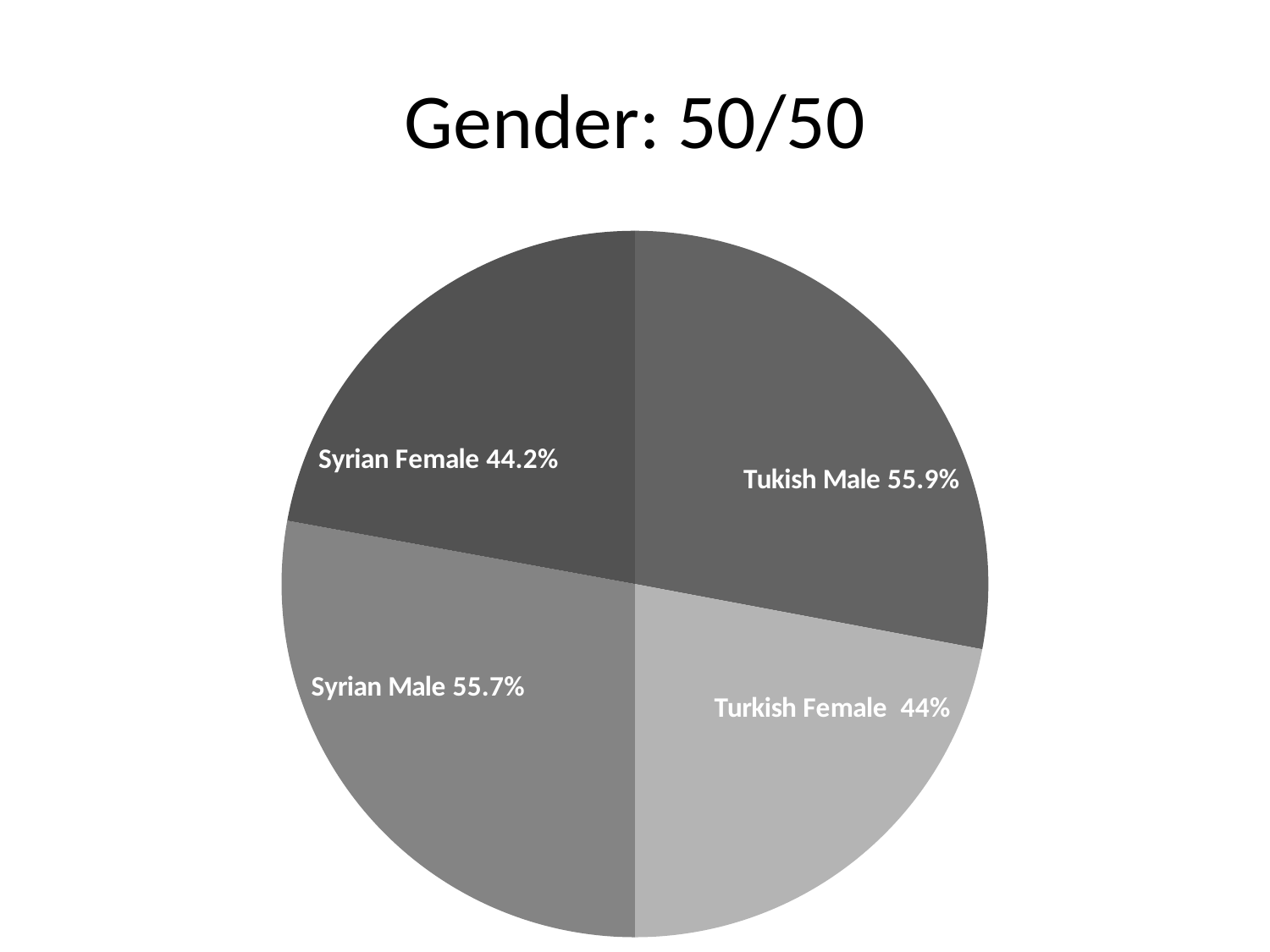
What kind of chart is shown on the slide? pie chart What value is shown for Turkish Female? 44% Which is larger, the value for Syrian Male or the value for Syrian Female? Syrian Male How many slices does the pie chart have? 4 What is the difference between the values for Syrian Male and Syrian Female? 11.5% What value is shown for Syrian Male? 55.7% What value is shown for Syrian Female? 44.2% Which slice is the lightest in colour? Turkish Female What is the title of the chart? Gender: 50/50 Which is larger, the value for Tukish Male or the value for Turkish Female? Tukish Male What value is shown for Tukish Male? 55.9% What is the difference between the values for Tukish Male and Turkish Female? 11.9%